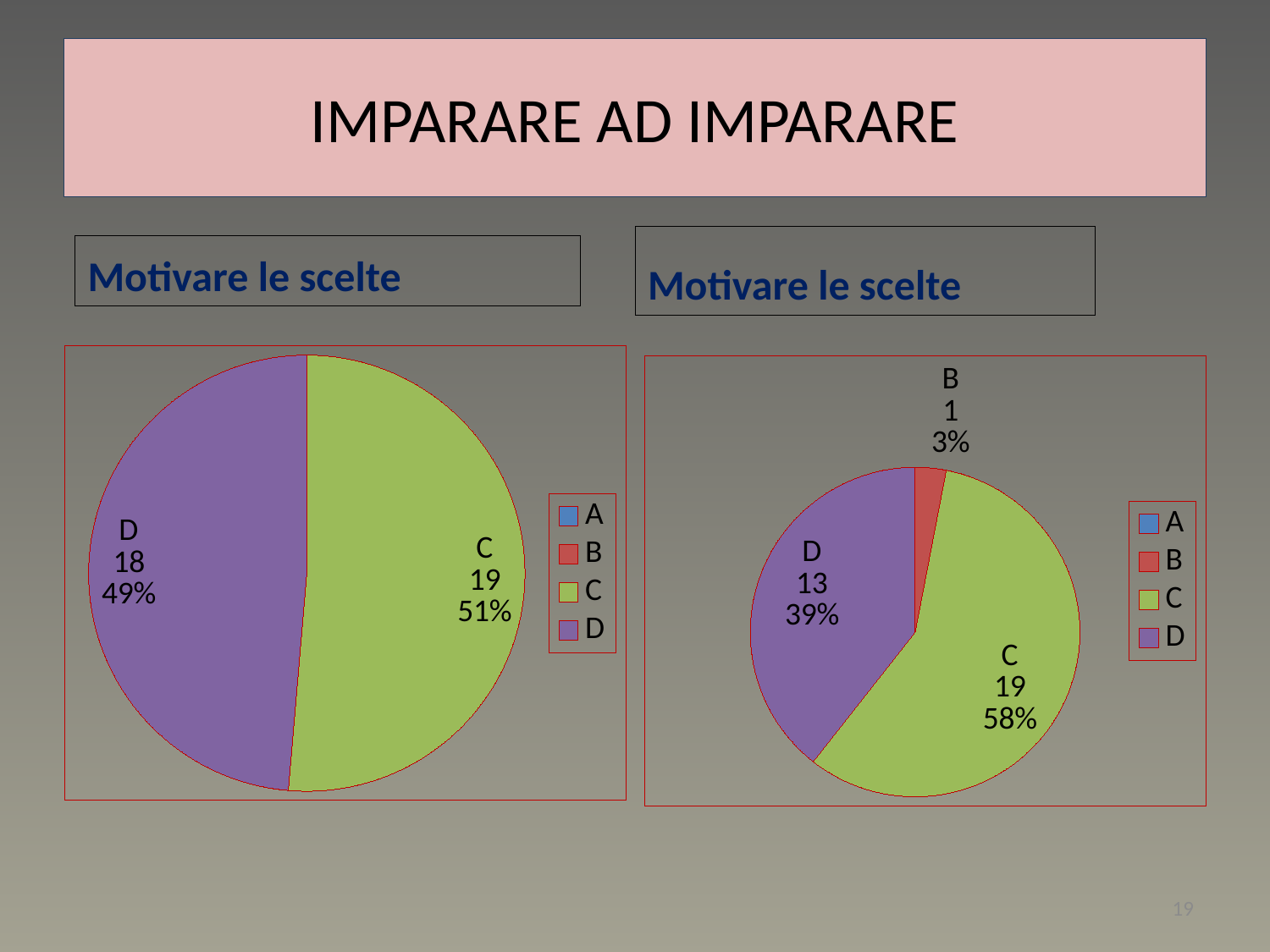
In the left pie chart, what share of the pie does slice D represent? 49% What type of chart is the left chart on the slide? Pie chart In the right pie chart, what share of the pie does slice C represent? 58% In the right pie chart, which category has the smallest slice? B In the right pie chart, what is the value for category D? 13 In the left pie chart, what is the difference between the values for C and D? 1 In the left pie chart, which category has the largest slice? C How many entries does the legend of the left pie chart list? 4 In the right pie chart, which is larger, the value for C or the value for D? C In the left pie chart, what is the value for category C? 19 In the right pie chart, what is the difference between the values for C and D? 6 How many slices with data labels does the right pie chart show? 3